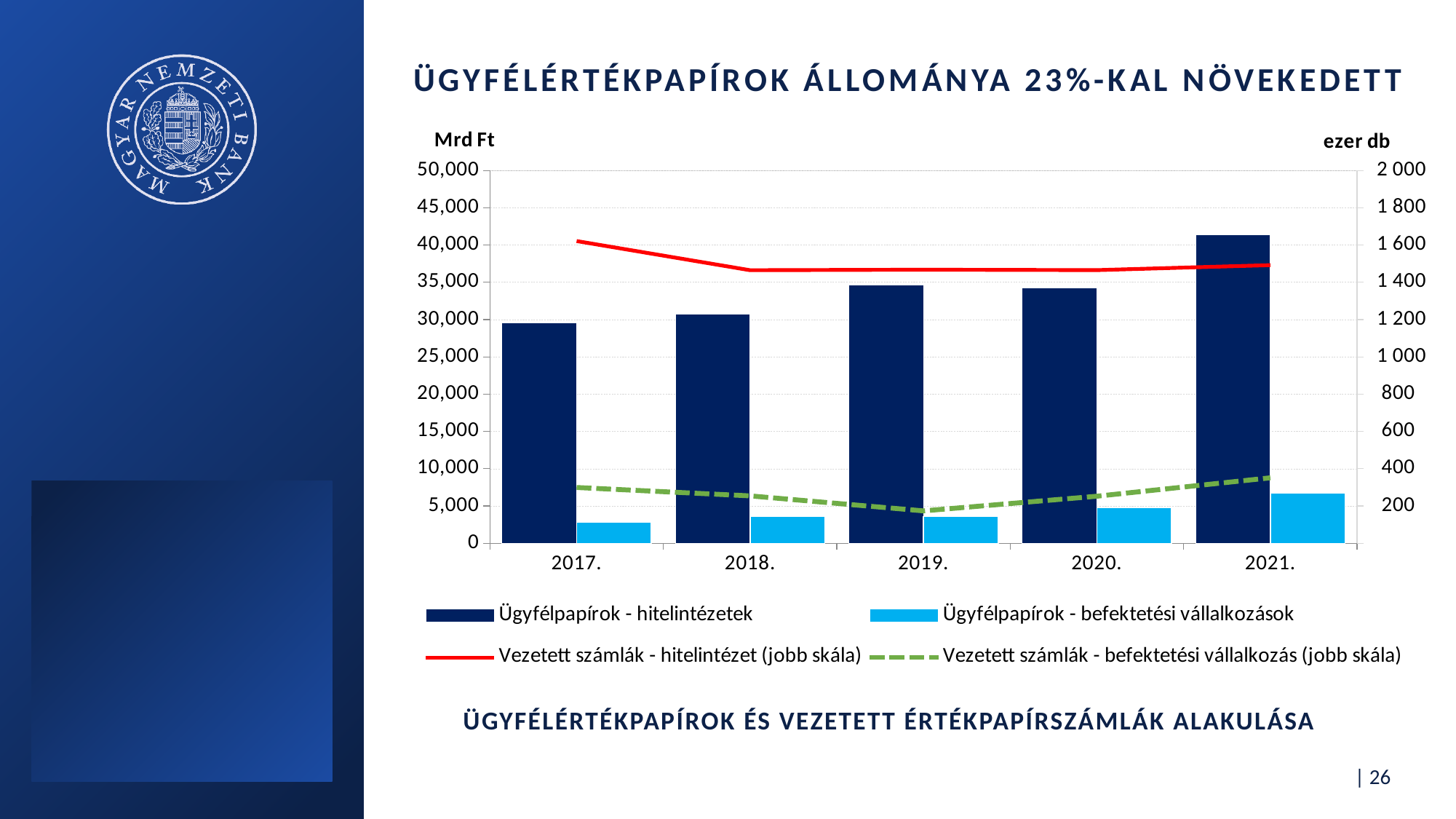
In which year is the bar for Ügyfélpapírok - hitelintézetek the highest? 2021. How many years are shown on the x axis of the chart? 5 In which year is the bar for Ügyfélpapírok - befektetési vállalkozások the highest? 2021. In which year does the dashed line Vezetett számlák - befektetési vállalkozás (jobb skála) reach its lowest point? 2019. Is the value for Ügyfélpapírok - hitelintézetek in 2021 greater or less than 40,000? greater What unit is shown on the left axis of the chart? Mrd Ft Which is larger, the Ügyfélpapírok - hitelintézetek bar for 2019 or for 2021? 2021. What kind of chart is shown on the slide? A combined bar and line chart How many series does the chart's legend list? 4 In which year is the bar for Ügyfélpapírok - hitelintézetek the lowest? 2017.